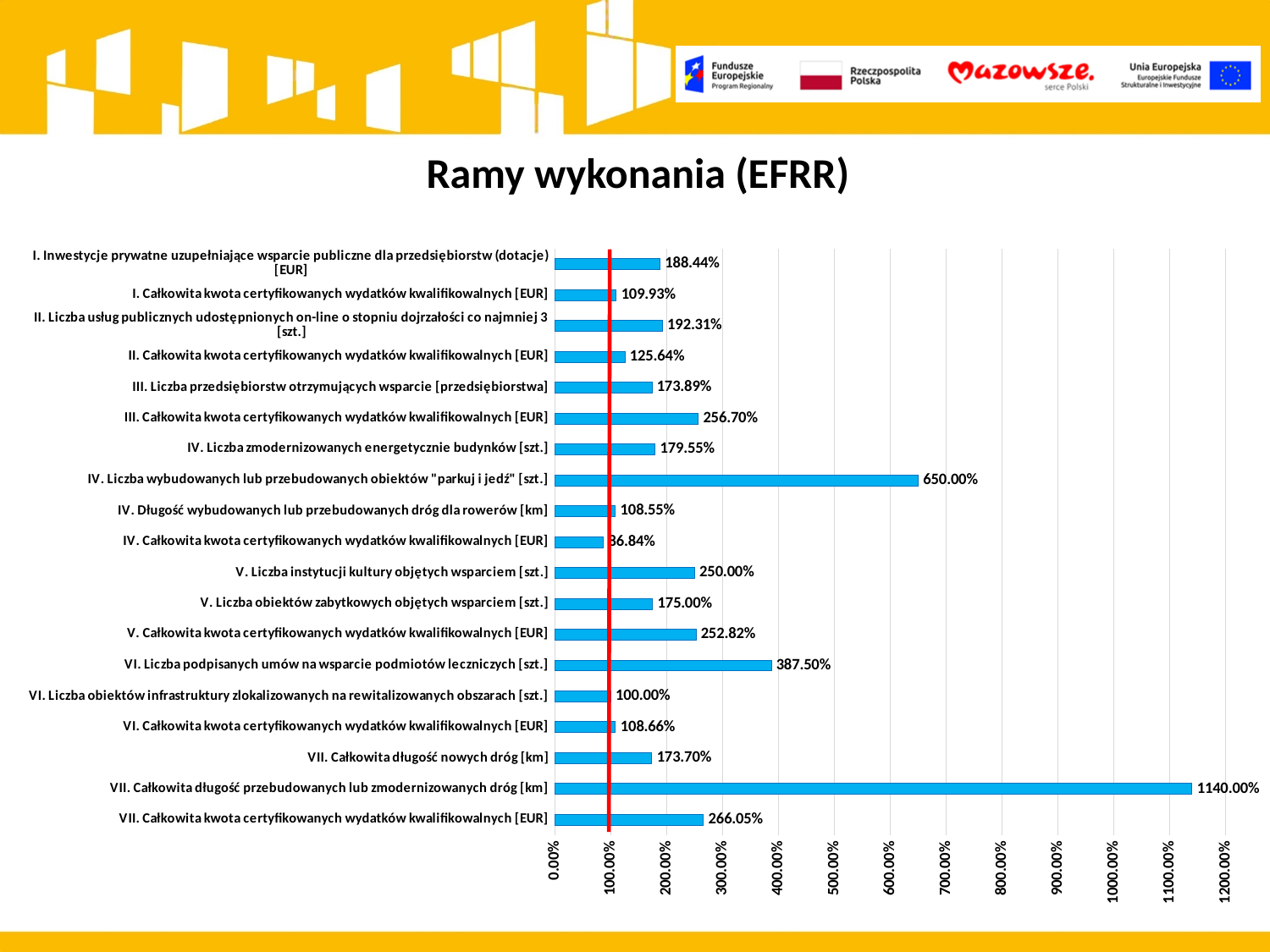
Which category has the highest value? VII. Całkowita długość przebudowanych lub zmodernizowanych dróg [km] What is the value for 'VII. Całkowita długość nowych dróg [km]'? 173.70% Which category has the lowest value? IV. Całkowita kwota certyfikowanych wydatków kwalifikowalnych [EUR] What type of chart is shown on the slide? bar chart Which is larger: the value for 'II. Liczba usług publicznych udostępnionych on-line o stopniu dojrzałości co najmniej 3 [szt.]' or for 'II. Całkowita kwota certyfikowanych wydatków kwalifikowalnych [EUR]'? II. Liczba usług publicznych udostępnionych on-line o stopniu dojrzałości co najmniej 3 [szt.] What is the difference between the values for 'V. Liczba instytucji kultury objętych wsparciem [szt.]' and 'V. Liczba obiektów zabytkowych objętych wsparciem [szt.]'? 75.00% What is the value for 'IV. Liczba wybudowanych lub przebudowanych obiektów "parkuj i jedź" [szt.]'? 650.00% What is the value for 'III. Całkowita kwota certyfikowanych wydatków kwalifikowalnych [EUR]'? 256.70% What is the value for 'VI. Liczba podpisanych umów na wsparcie podmiotów leczniczych [szt.]'? 387.50% Is the value for 'VI. Liczba podpisanych umów na wsparcie podmiotów leczniczych [szt.]' greater or less than 300.00%? greater What is the difference between the values for 'VII. Całkowita długość przebudowanych lub zmodernizowanych dróg [km]' and 'IV. Liczba wybudowanych lub przebudowanych obiektów "parkuj i jedź" [szt.]'? 490.00% How many categories are shown in the chart? 19